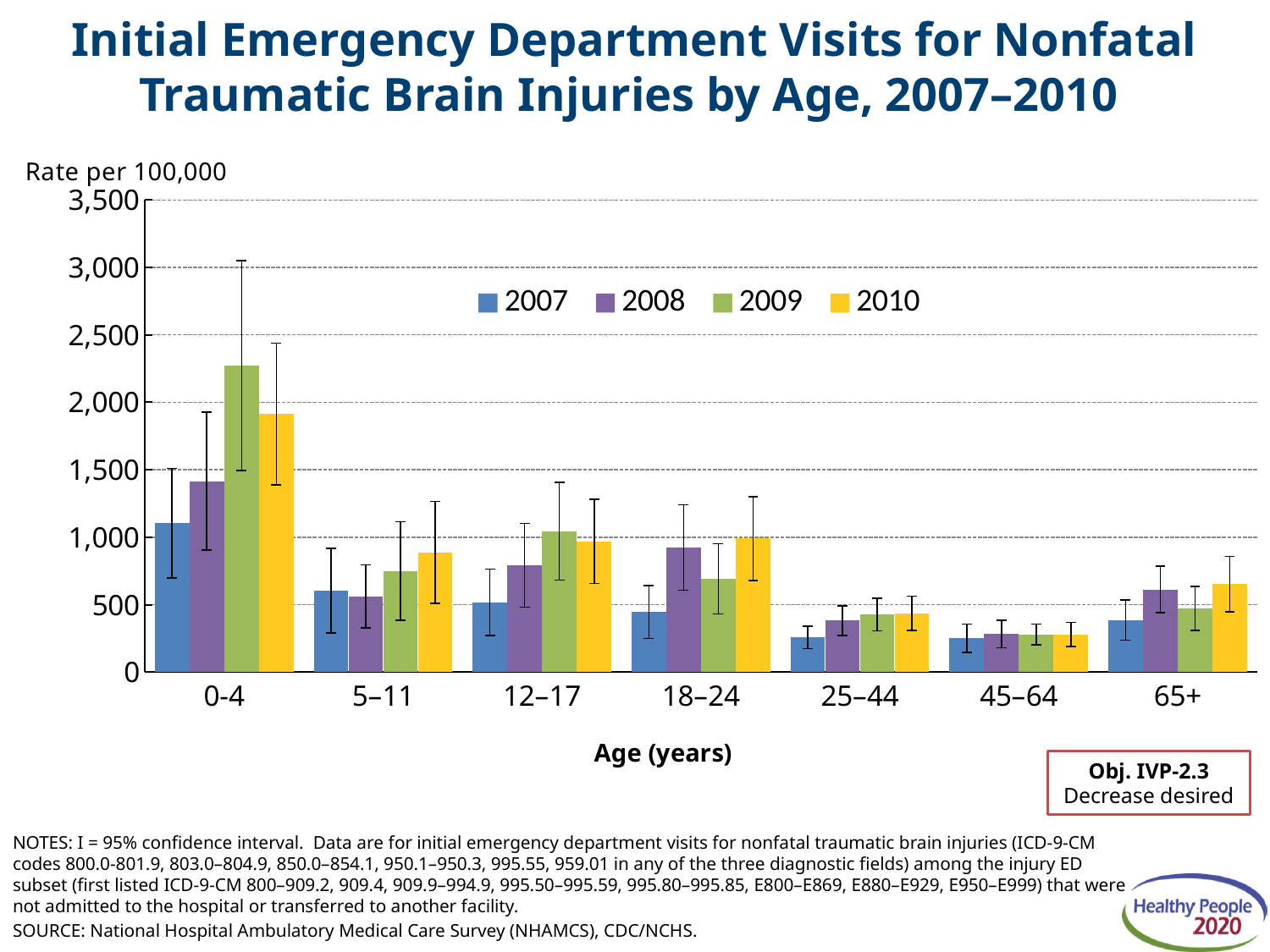
For the 12–17 age group, which year has the larger rate, 2007 or 2009? 2009 For the 0-4 age group, which year has the larger rate, 2009 or 2010? 2009 What type of chart is shown on the slide? Bar chart Is the 2009 rate for the 0-4 age group greater or less than 2,000? greater Is the 2007 rate for the 25–44 age group greater or less than 500? less What is the label on the y axis of the chart? Rate per 100,000 Which age group has the highest rate for 2009? 0-4 Which age group has the lowest rate for 2010? 45–64 Is the 2010 rate for the 18–24 age group greater or less than 500? greater How many series does the legend list? 4 How many age groups are shown on the x axis? 7